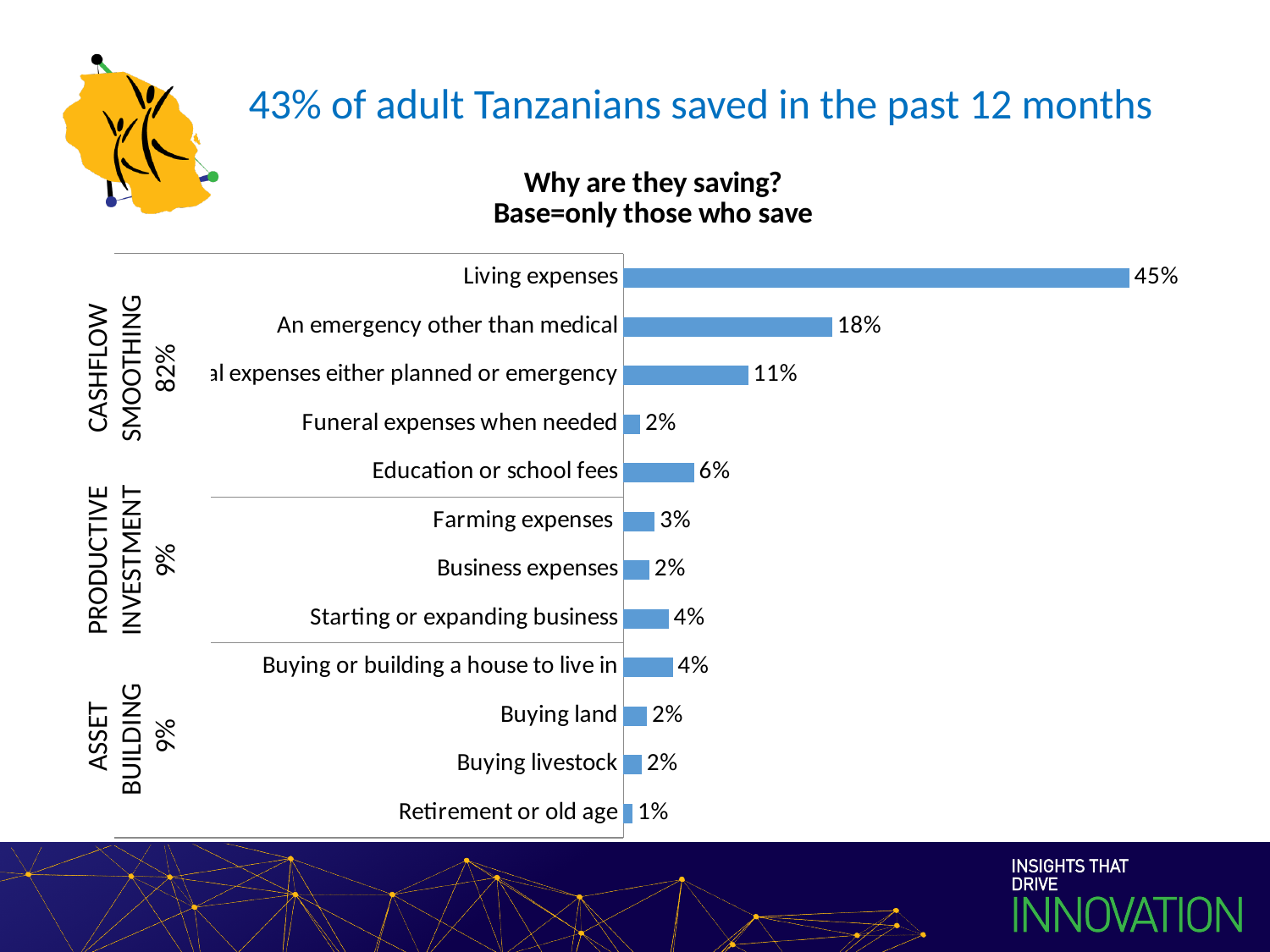
What is the base stated under the chart heading 'Why are they saving?'? Base=only those who save What percentage of savers save for living expenses? 45% How many saving reasons (categories) are plotted in the chart? 12 What is the value for 'Retirement or old age'? 1% Which saving reason has the highest value? Living expenses What is the difference between the values for 'Living expenses' and 'An emergency other than medical'? 27 percentage points Which saving reason has the lowest value? Retirement or old age Which is larger, the value for 'Education or school fees' or the value for 'Farming expenses'? Education or school fees What kind of chart is shown on the slide? bar chart What is the value for 'An emergency other than medical'? 18% What percentage is shown for the 'Cashflow smoothing' group? 82% What is the value for 'Education or school fees'? 6%